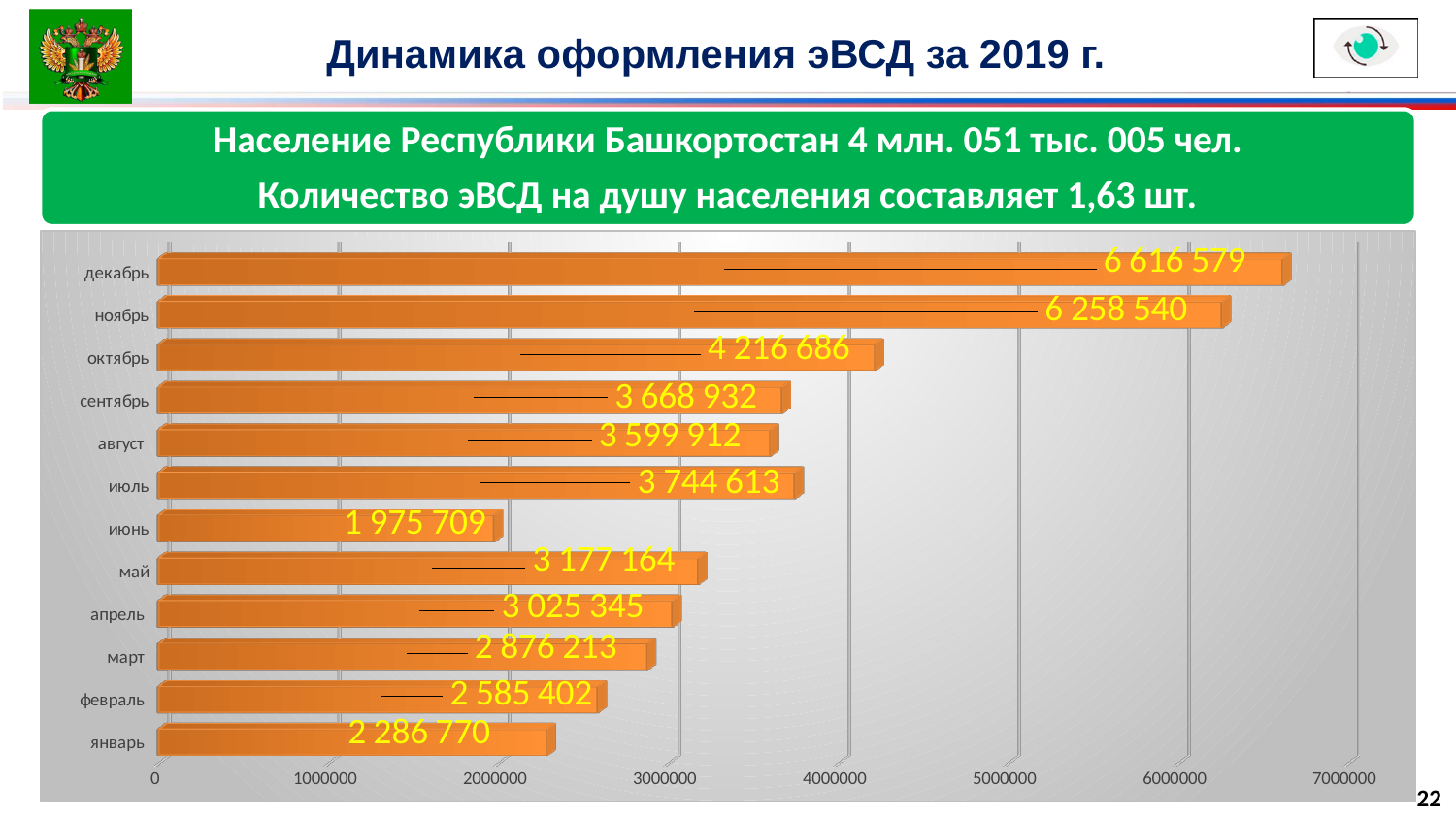
What is the value for январь? 2 286 770 What is the difference between the values for декабрь and ноябрь? 358 039 Which month has the highest value? декабрь What type of chart is shown on the slide? Bar chart Is the value for октябрь greater or less than 4000000? greater Which is larger, the value for сентябрь or the value for август? сентябрь How many months are shown in the chart? 12 What is the value for июнь? 1 975 709 What is the value for декабрь? 6 616 579 Which month has the lowest value? июнь What is the difference between the values for июль and август? 144 701 What is the title of the slide containing the chart? Динамика оформления эВСД за 2019 г.